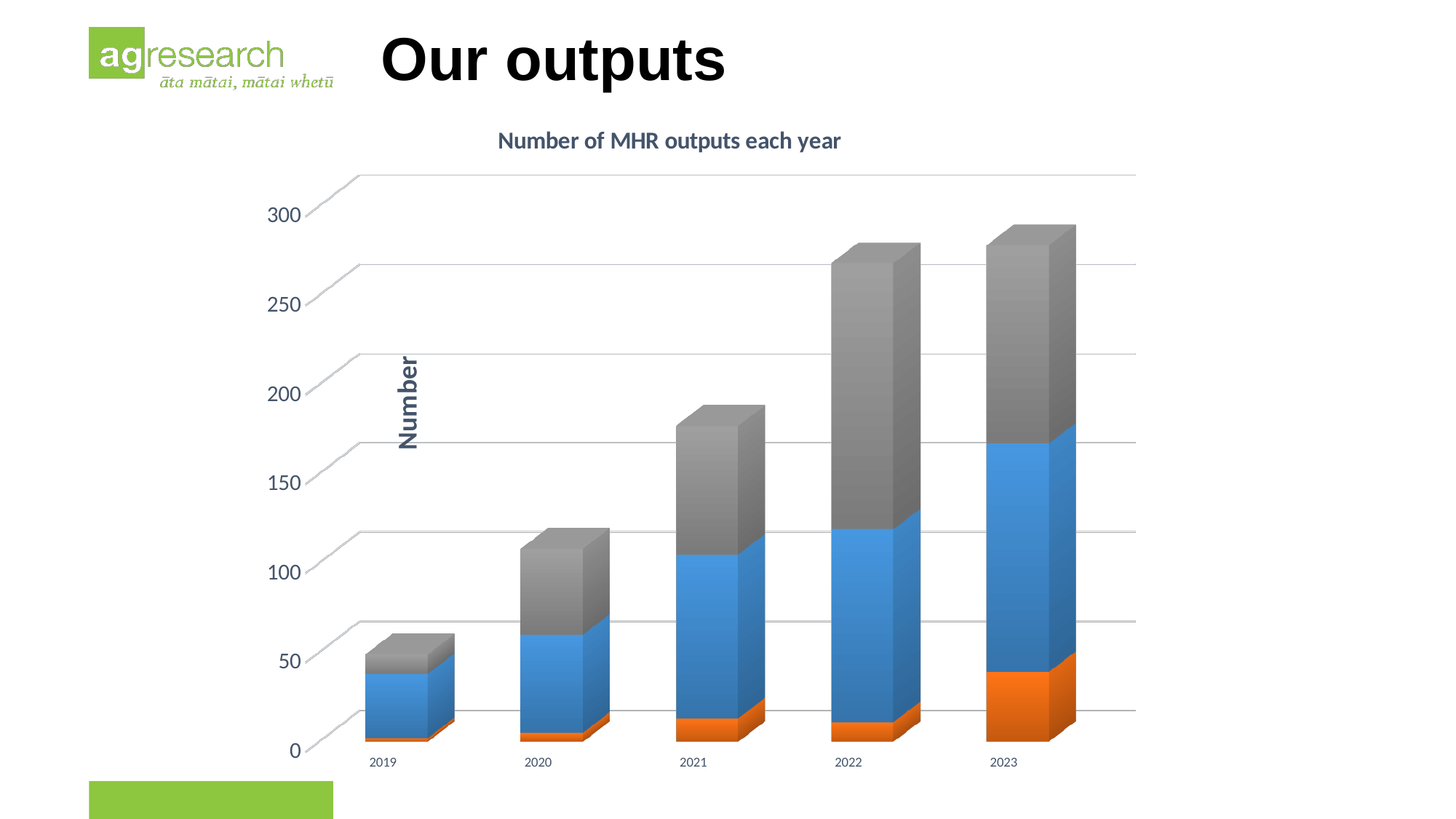
What is the label on the vertical axis of the chart? Number Is the total value for 2021 greater or less than 150? greater How many years are shown on the x axis of the chart? 5 Is the total value for 2020 greater or less than 150? less Which year has the lowest total number of MHR outputs? 2019 Is the total value for 2019 greater or less than 100? less Which year has the highest total number of MHR outputs? 2023 What kind of chart is shown on the slide? bar chart What is the title of the chart? Number of MHR outputs each year Which year has a larger total number of MHR outputs, 2020 or 2022? 2022 Do the total number of MHR outputs rise or fall from 2019 to 2023? rise